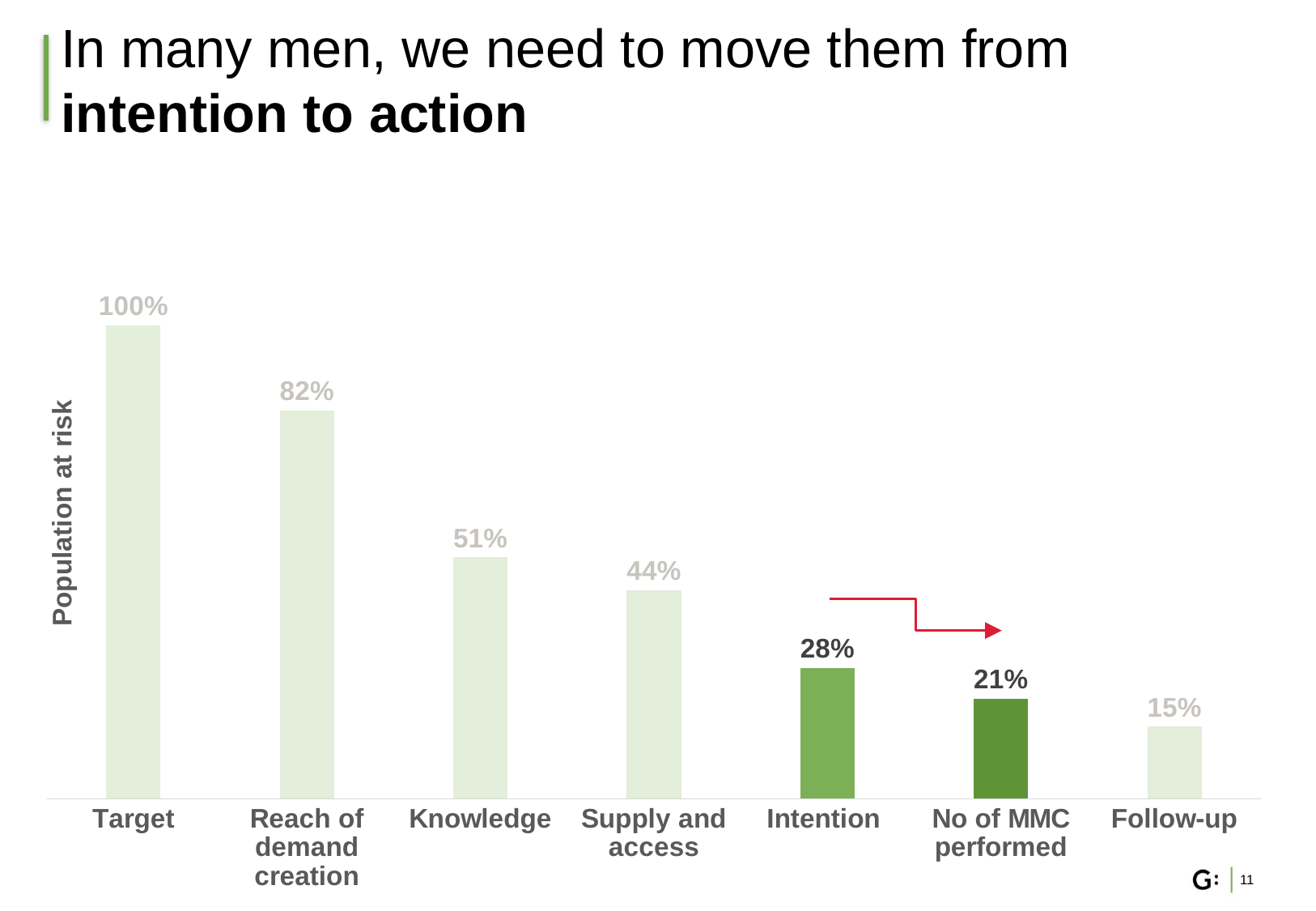
Which category has the highest value? Target What is the difference between the values for Intention and No of MMC performed? 7% How many categories are shown on the x axis? 7 What is the value for Intention? 28% What is the value for Reach of demand creation? 82% Which category has the lowest value? Follow-up Which is larger, the value for Supply and access or the value for Follow-up? Supply and access Do the values rise or fall from Target to Follow-up along the x axis? Fall What is the difference between the values for Knowledge and Supply and access? 7% What is the value for Knowledge? 51% What is the value for No of MMC performed? 21% What kind of chart is shown on the slide? Bar chart